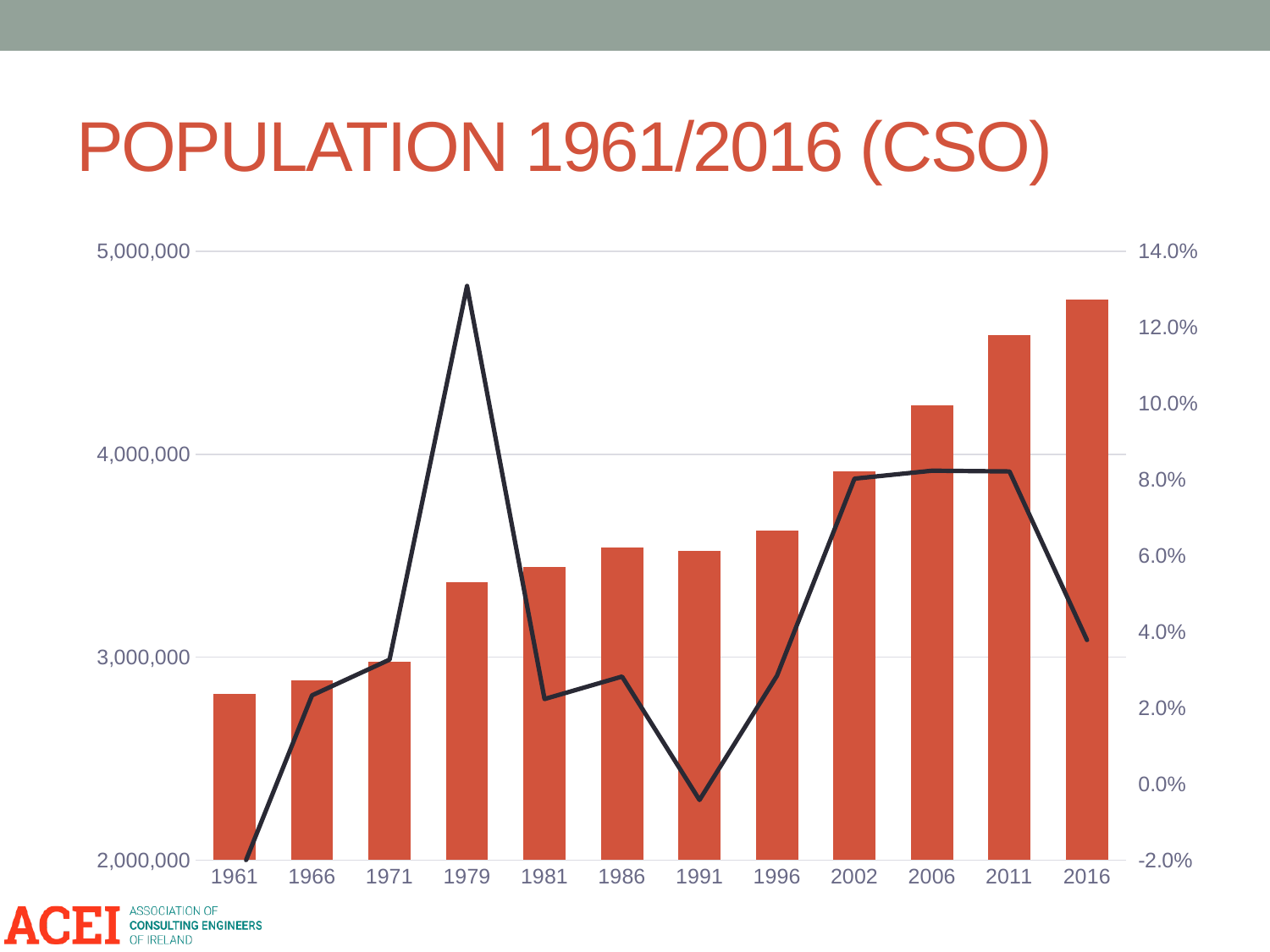
Is the line value for 1979 greater or less than 12.0%? greater What kind of chart is shown on the slide? A combined bar and line chart Which bar is taller, 2006 or 2011? 2011 What is the title of the chart? POPULATION 1961/2016 (CSO) Do the bars generally rise or fall from 1961 to 2016? rise How many years are shown along the x axis? 12 In which year does the line reach its highest point? 1979 Is the bar for 2002 greater or less than 3,000,000? greater Which year has the shortest bar? 1961 Which year has the tallest bar? 2016 Is the bar for 1961 greater or less than 3,000,000? less